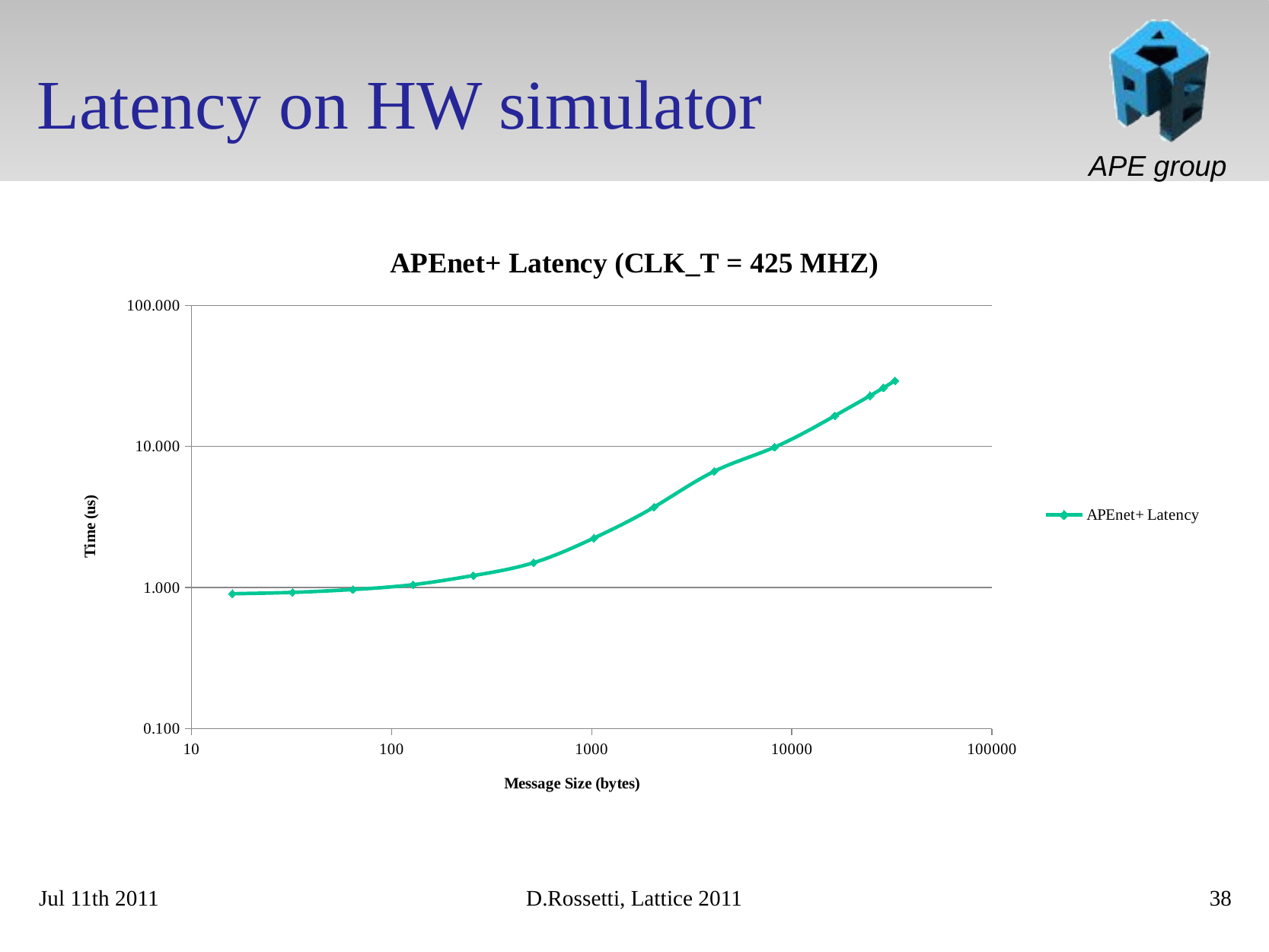
What is the title of the chart? APEnet+ Latency (CLK_T = 425 MHZ) Is the latency value at a message size of about 1000 bytes greater or less than 1.000 us? greater Does the latency rise or fall as message size increases along the x axis? rise At which message size is the latency highest: the smallest or the largest message size plotted? the largest message size Is the latency value at the largest message size plotted greater or less than 10.000 us? greater Is the latency value at a message size of about 100 bytes greater or less than 10.000 us? less What kind of chart is shown on the slide? line chart Which has the higher latency: the point at about 1000 bytes or the point at about 10000 bytes? the point at about 10000 bytes What is the name of the series shown in the legend? APEnet+ Latency How many series does the legend list? 1